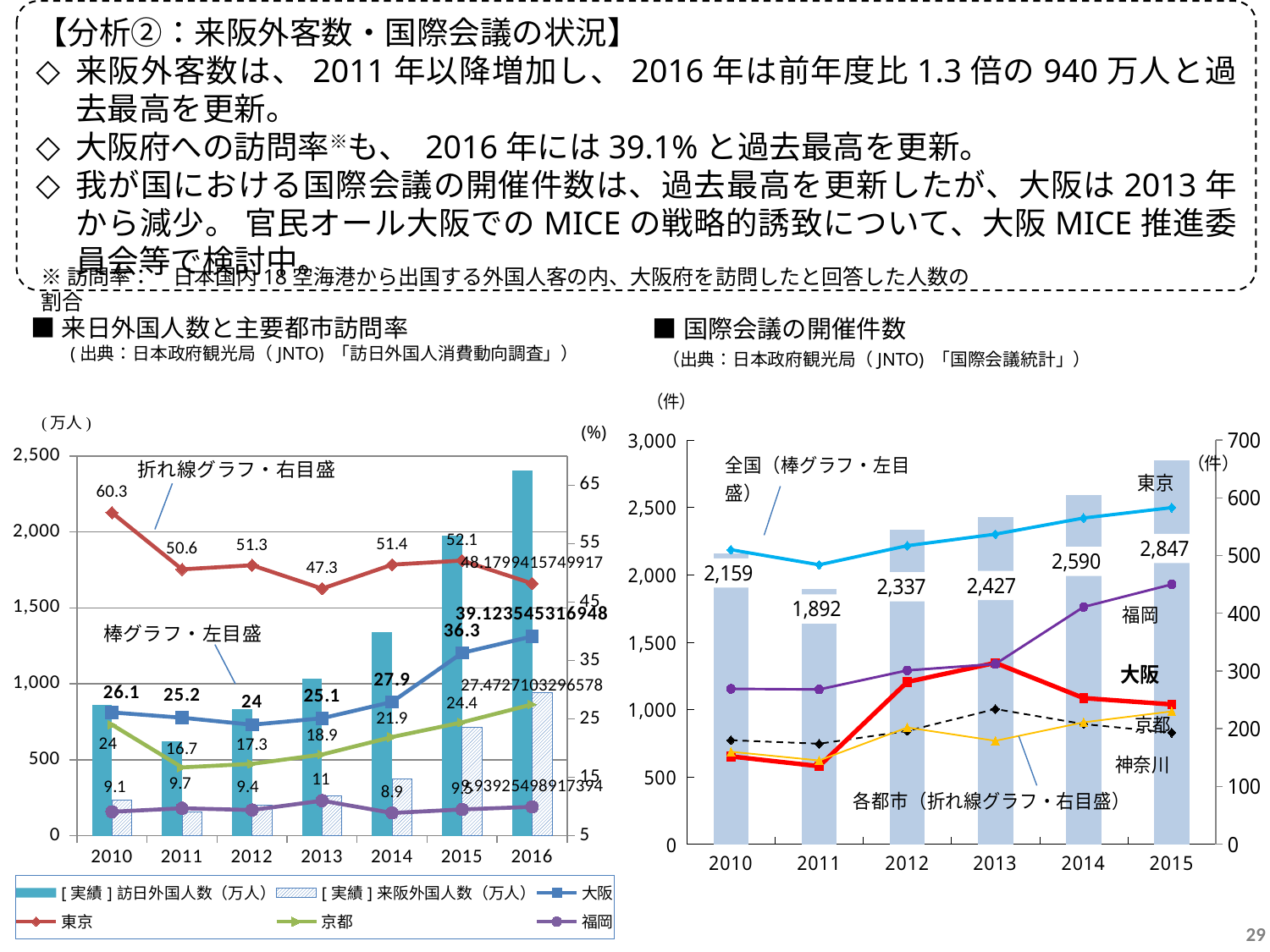
In the 国際会議の開催件数 chart on the right, do the 全国 bars rise or fall from 2011 to 2015? rise In the 国際会議の開催件数 chart on the right, what is the 全国 value for 2011? 1,892 In the 国際会議の開催件数 chart on the right, which year has the lowest 全国 value? 2011 In the 国際会議の開催件数 chart on the right, what is the difference between the 全国 values for 2015 and 2014? 257 In the 来日外国人数と主要都市訪問率 chart on the left, what is the 東京 value for 2010? 60.3 In the 国際会議の開催件数 chart on the right, how many years are shown on the x axis? 6 In the 来日外国人数と主要都市訪問率 chart on the left, which is larger in 2014, the 大阪 value or the 京都 value? 大阪 In the 来日外国人数と主要都市訪問率 chart on the left, what is the difference between the 大阪 values for 2015 and 2014? 8.4 In the 来日外国人数と主要都市訪問率 chart on the left, is the 訪日外国人数 bar for 2016 greater or less than 2,000? greater In the 来日外国人数と主要都市訪問率 chart on the left, what is the 大阪 value for 2015? 36.3 In the 国際会議の開催件数 chart on the right, what is the 全国 value for 2015? 2,847 In the 来日外国人数と主要都市訪問率 chart on the left, how many series does the legend list? 6